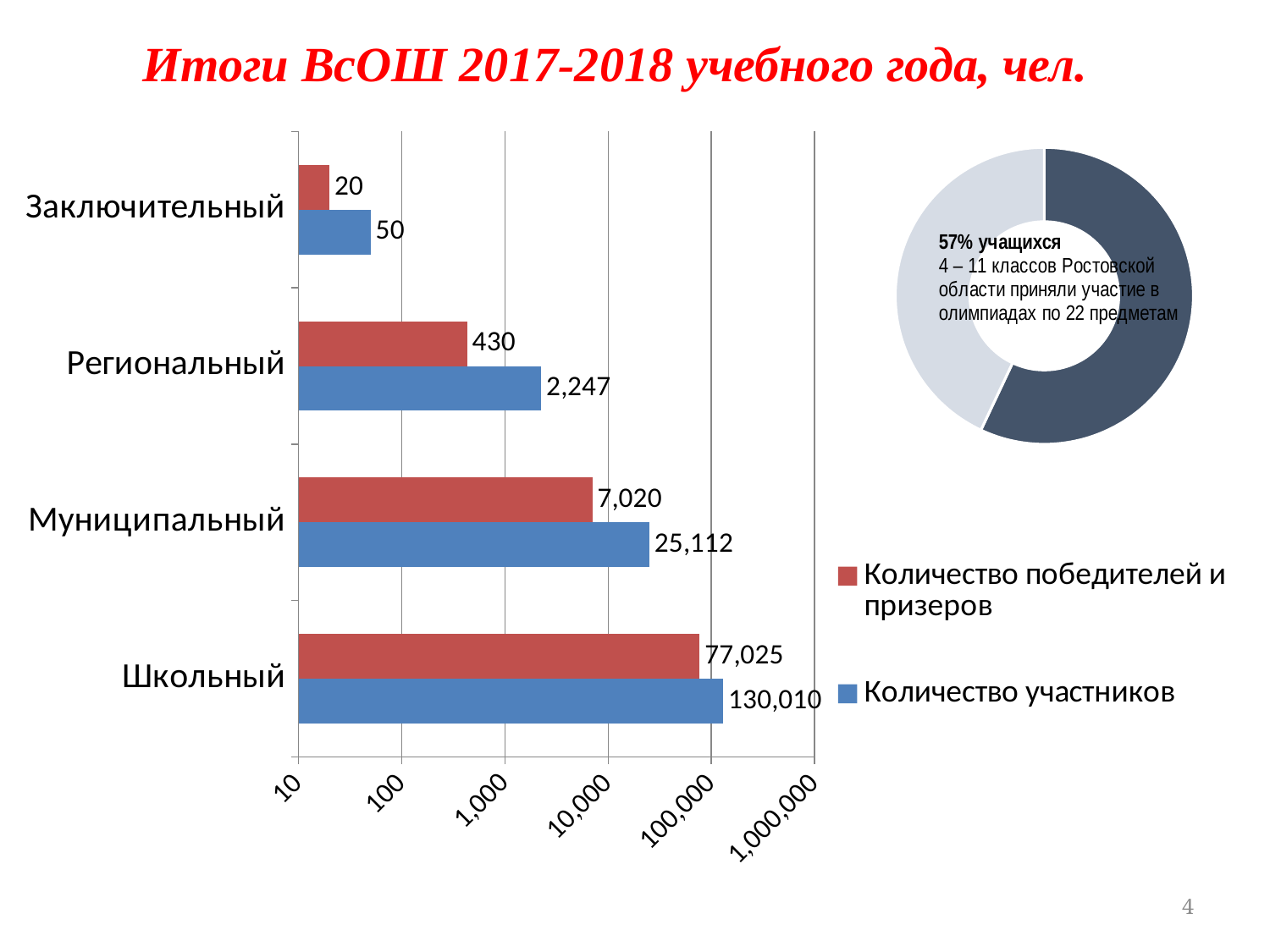
In the bar chart on the left, which category has the lowest value of Количество победителей и призеров? Заключительный In the bar chart on the left, which category has the highest value of Количество участников? Школьный In the bar chart on the left, what is the value of Количество победителей и призеров for Региональный? 430 How many series does the legend of the bar chart on the left list? 2 How many categories are shown in the bar chart on the left? 4 In the bar chart on the left, what is the value of Количество участников for Школьный? 130,010 In the bar chart on the left, what is the value of Количество участников for Муниципальный? 25,112 In the bar chart on the left, which is larger: Количество участников for Региональный or Количество победителей и призеров for Муниципальный? Количество победителей и призеров for Муниципальный In the bar chart on the left, what is the difference between Количество участников and Количество победителей и призеров for Школьный? 52,985 What kind of chart is the chart on the left of the slide? bar chart In the bar chart on the left, what is the difference between Количество участников and Количество победителей и призеров for Заключительный? 30 In the donut chart on the right, what share of students is shown as having taken part in the olympiads? 57%